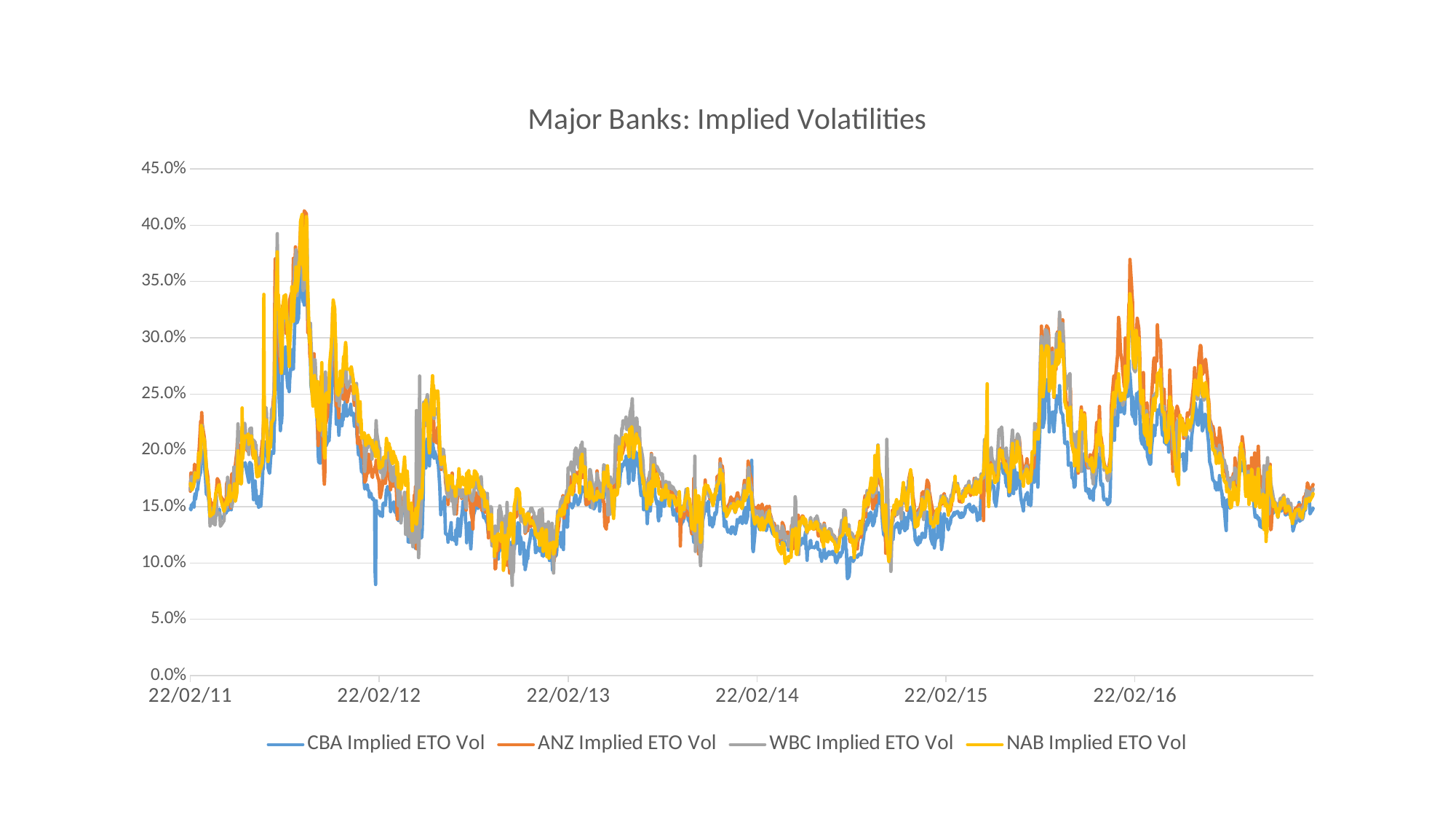
How many series does the legend list? 4 What kind of chart is shown on the slide? Line chart Is the highest value reached by the ANZ Implied ETO Vol series around 22/02/16 greater or less than 30.0%? greater Is the highest value reached by any series in late 2011 greater or less than 35.0%? greater Is the lowest value reached by the CBA Implied ETO Vol series greater or less than 10.0%? less How many date labels are shown on the x axis? 6 Which series reaches the highest peak in the period around 22/02/16? ANZ Implied ETO Vol Which colour is used for the CBA Implied ETO Vol series? Blue Do the implied volatilities generally rise or fall between 22/02/14 and 22/02/16? Rise What is the title of the chart? Major Banks: Implied Volatilities Do the implied volatilities generally rise or fall between the late-2011 peak and 22/02/13? Fall